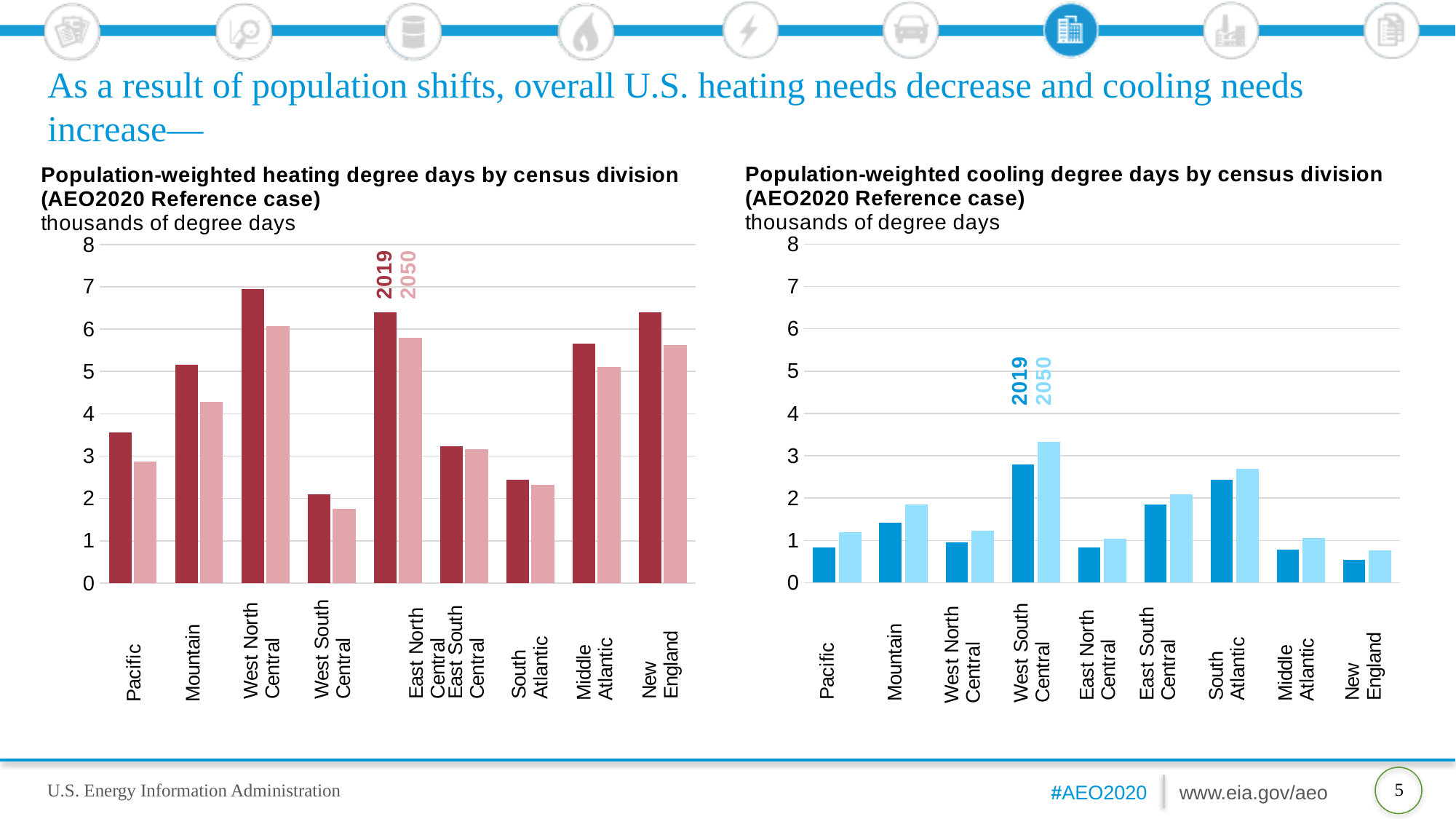
In the cooling degree days chart, which census division has the lowest value for 2019? New England In the cooling degree days chart, which is larger for South Atlantic: the 2019 value or the 2050 value? 2050 In the heating degree days chart, which census division has the lowest value for 2019? West South Central In the heating degree days chart, which census division has the highest value for 2019? West North Central In the cooling degree days chart, is the 2050 value for West South Central greater or less than 3? greater How many census divisions are shown on the x axis of the heating degree days chart? 9 In the cooling degree days chart, which census division has the highest value for 2050? West South Central In the heating degree days chart, which is larger for Mountain: the 2019 value or the 2050 value? 2019 In the cooling degree days chart, is the 2019 value for New England greater or less than 1? less In the heating degree days chart, is the 2050 value for Pacific greater or less than 3? less How many series does the legend of the cooling degree days chart list? 2